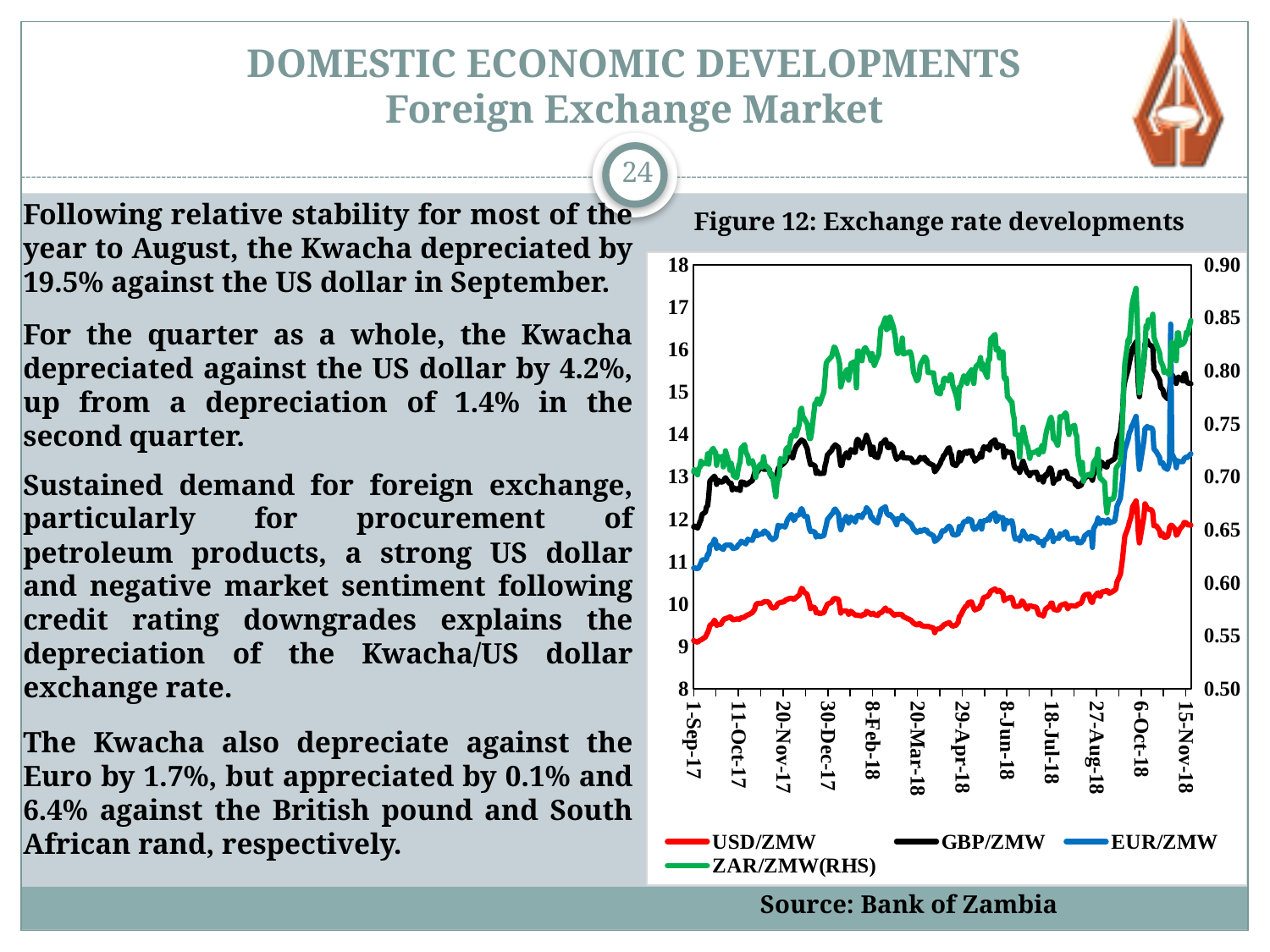
In Figure 12, is the EUR/ZMW value at 1-Sep-17 greater or less than 12? less In Figure 12, is the USD/ZMW value at 15-Nov-18 greater or less than 11? greater What kind of chart is Figure 12: Exchange rate developments? line chart How many date labels are shown on the x axis of Figure 12? 12 In Figure 12, is the USD/ZMW value at 1-Sep-17 greater or less than 10? less In Figure 12, does the USD/ZMW line rise or fall between 27-Aug-18 and 6-Oct-18? rise How many series does the legend of Figure 12 list? 4 In Figure 12, which of the series plotted on the left-hand axis has the lowest values? USD/ZMW In Figure 12, which line is higher throughout the period, GBP/ZMW or USD/ZMW? GBP/ZMW In Figure 12, which series is plotted against the right-hand axis? ZAR/ZMW(RHS)